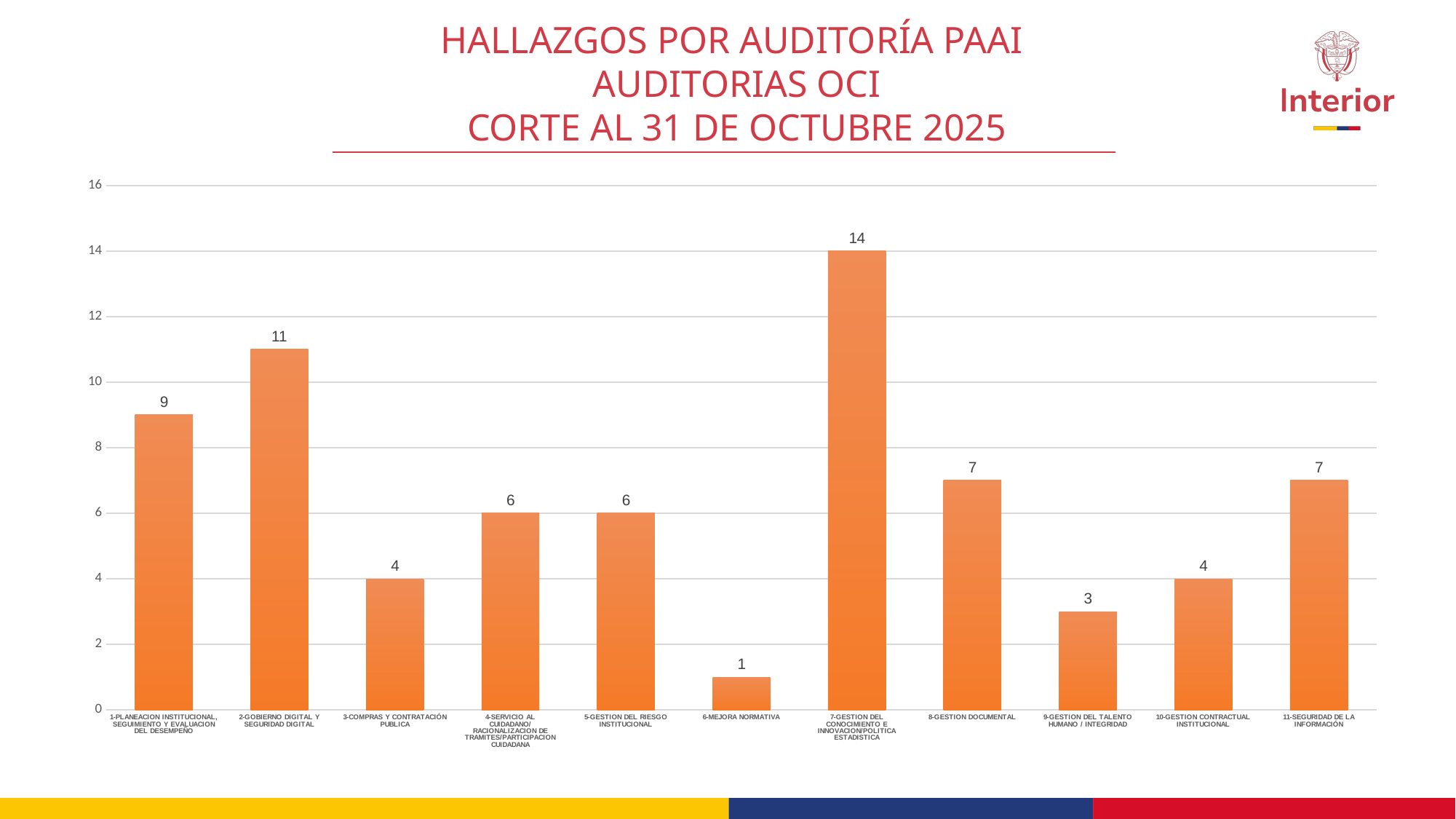
What is the value for 9-GESTION DEL TALENTO HUMANO / INTEGRIDAD? 3 What kind of chart is shown on the slide? bar chart What is the difference between the values for 1-PLANEACION INSTITUCIONAL, SEGUIMIENTO Y EVALUACION DEL DESEMPEÑO and 3-COMPRAS Y CONTRATACIÓN PUBLICA? 5 What is the value for 2-GOBIERNO DIGITAL Y SEGURIDAD DIGITAL? 11 What is the value for 6-MEJORA NORMATIVA? 1 What is the highest value shown on the vertical axis? 16 Which is larger, the value for 2-GOBIERNO DIGITAL Y SEGURIDAD DIGITAL or the value for 11-SEGURIDAD DE LA INFORMACIÓN? 2-GOBIERNO DIGITAL Y SEGURIDAD DIGITAL Which category has the lowest value? 6-MEJORA NORMATIVA How many categories are shown on the x axis? 11 Is the value for 10-GESTION CONTRACTUAL INSTITUCIONAL greater or less than 6? less What is the difference between the values for 7-GESTION DEL CONOCIMIENTO E INNOVACION/POLITICA ESTADISTICA and 8-GESTION DOCUMENTAL? 7 Which category has the highest value? 7-GESTION DEL CONOCIMIENTO E INNOVACION/POLITICA ESTADISTICA